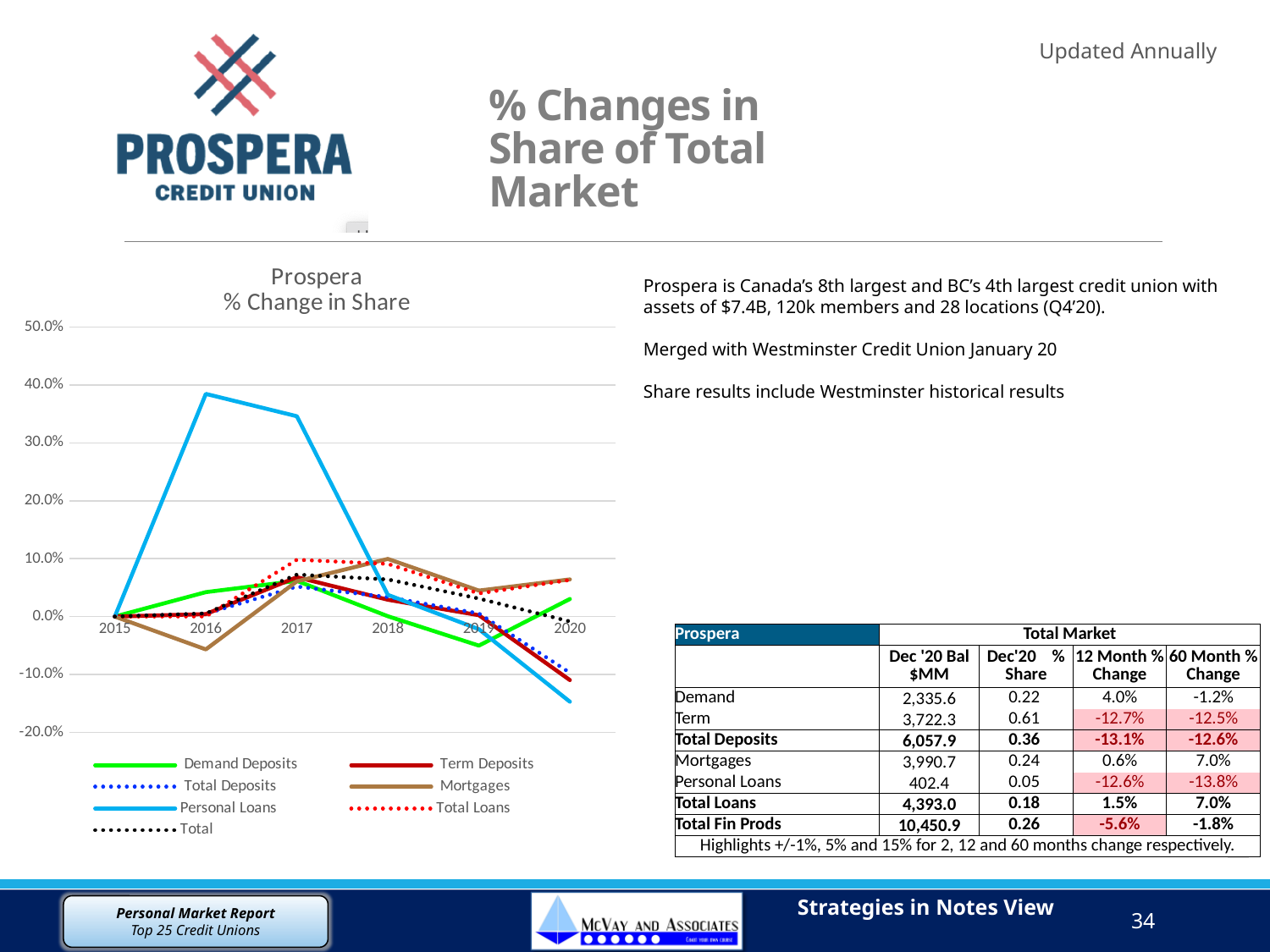
Is the value for Personal Loans in 2020 greater or less than -10.0%? less Does the Personal Loans line rise or fall from 2017 to 2020? fall In which year does the Personal Loans line reach its highest value? 2016 In 2017, which is larger: the value for Personal Loans or the value for Demand Deposits? Personal Loans How many series does the legend of the "Prospera % Change in Share" chart list? 7 Is the value for Mortgages in 2016 greater or less than 0.0%? less How many years are shown on the x axis of the chart? 6 Which series has the highest value in 2016? Personal Loans What is the title of the chart on the slide? Prospera % Change in Share Which series has the lowest value in 2016? Mortgages Is the value for Personal Loans in 2016 greater or less than 30.0%? greater What kind of chart is shown on the slide? line chart